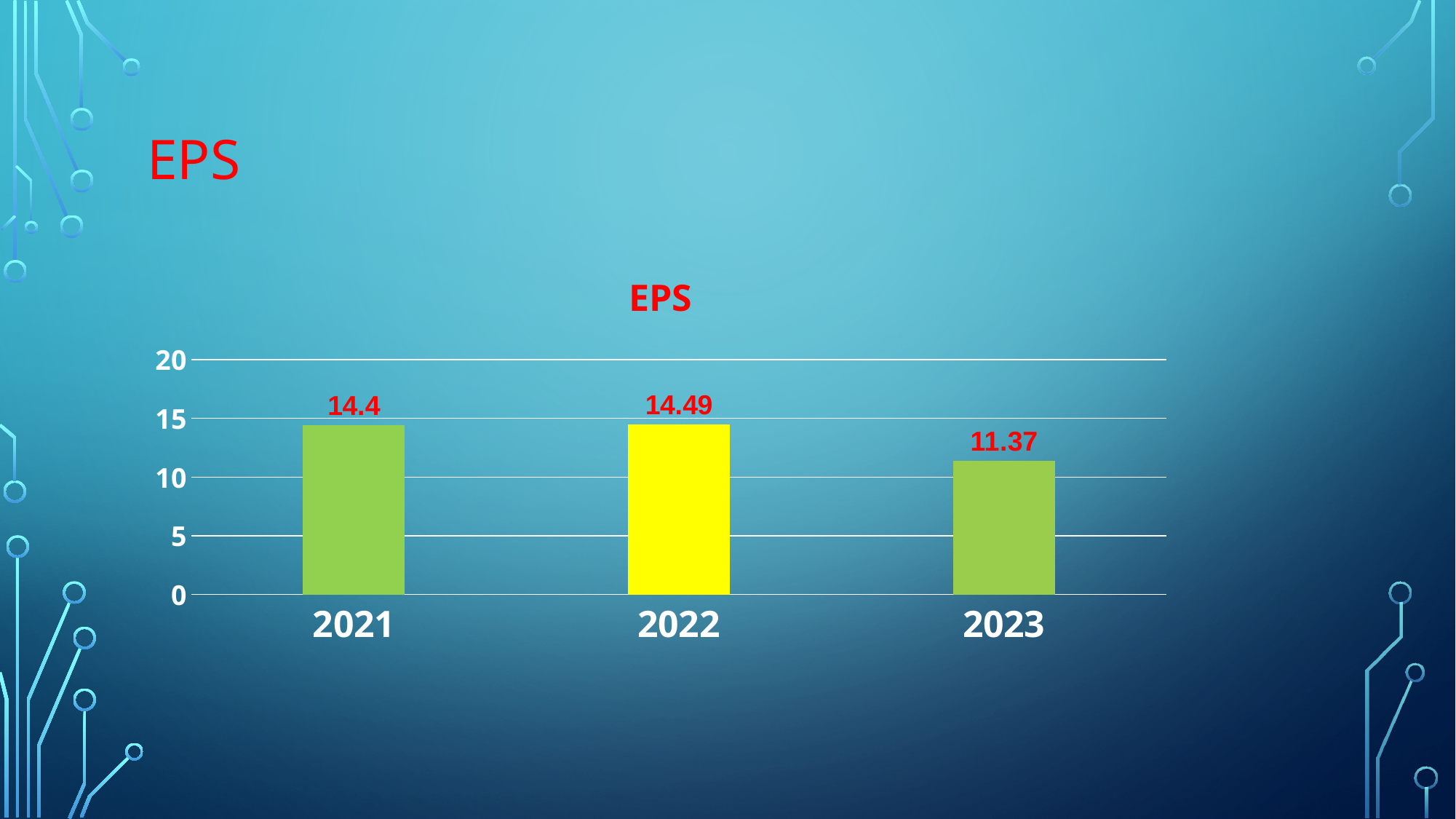
Which year has the lowest EPS? 2023 What is the EPS value for 2021? 14.4 Which year has the highest EPS? 2022 Does the EPS rise or fall from 2022 to 2023? fall What is the EPS value for 2022? 14.49 What kind of chart is shown on the slide? bar chart What is the EPS value for 2023? 11.37 Is the EPS value for 2023 greater or less than 10? greater How many years are shown on the chart? 3 What is the difference between the EPS for 2022 and 2023? 3.12 What is the difference between the EPS for 2021 and 2023? 3.03 Which is larger, the EPS for 2021 or the EPS for 2023? 2021